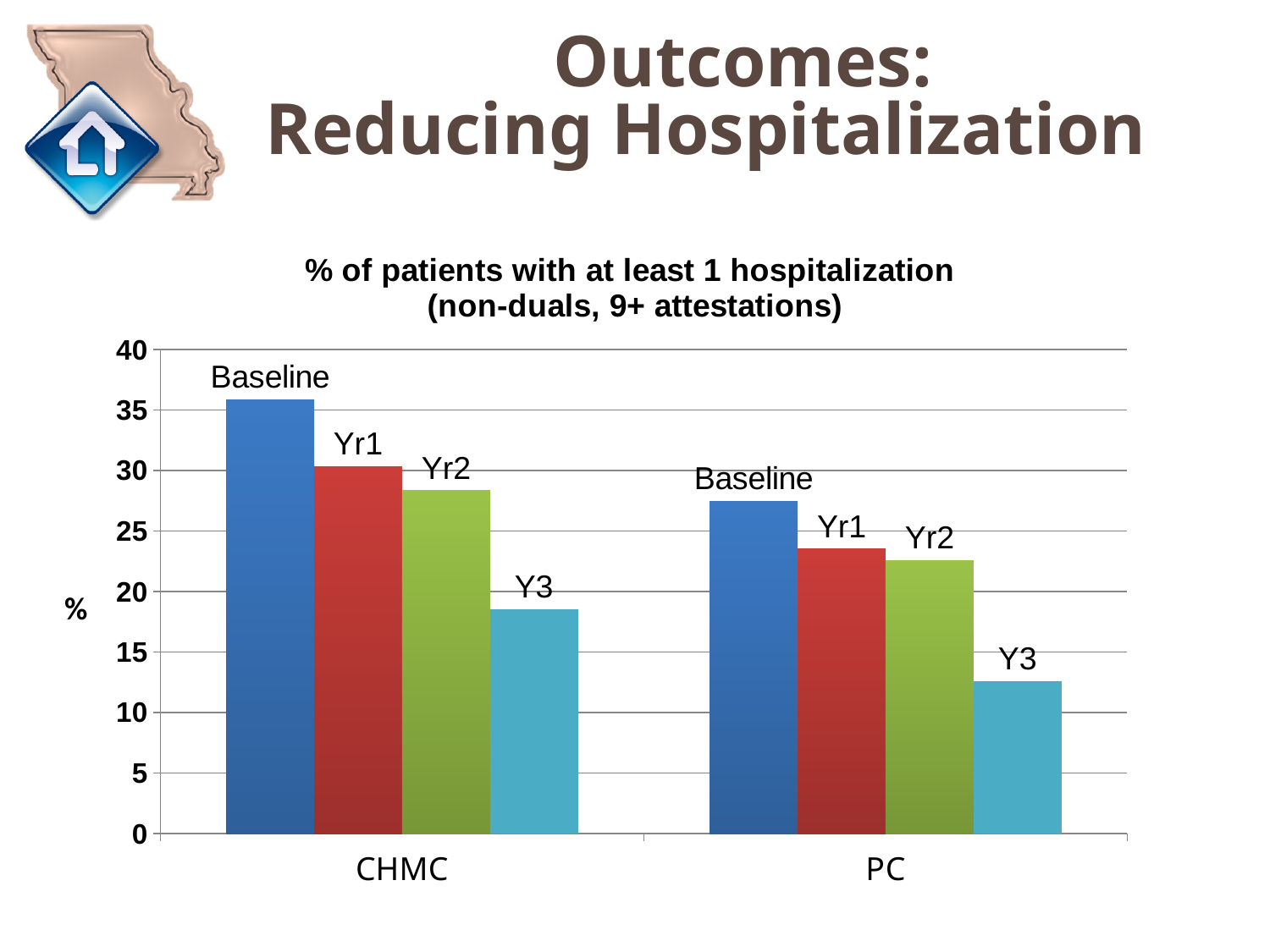
Is the Baseline value for CHMC greater or less than 30? greater Is the Baseline value for PC greater or less than 25? greater Which is larger, the Baseline value for CHMC or the Baseline value for PC? CHMC What is the title of the chart? % of patients with at least 1 hospitalization (non-duals, 9+ attestations) How many bars (series) are shown for each category in the chart? 4 Which bar in the chart is the lowest overall? PC Y3 Within the CHMC group, which bar is the lowest? Y3 What kind of chart is shown on the slide? bar chart Is the Y3 value for PC greater or less than 15? less How many categories are shown on the x axis of the chart? 2 Which bar in the chart is the highest overall? CHMC Baseline